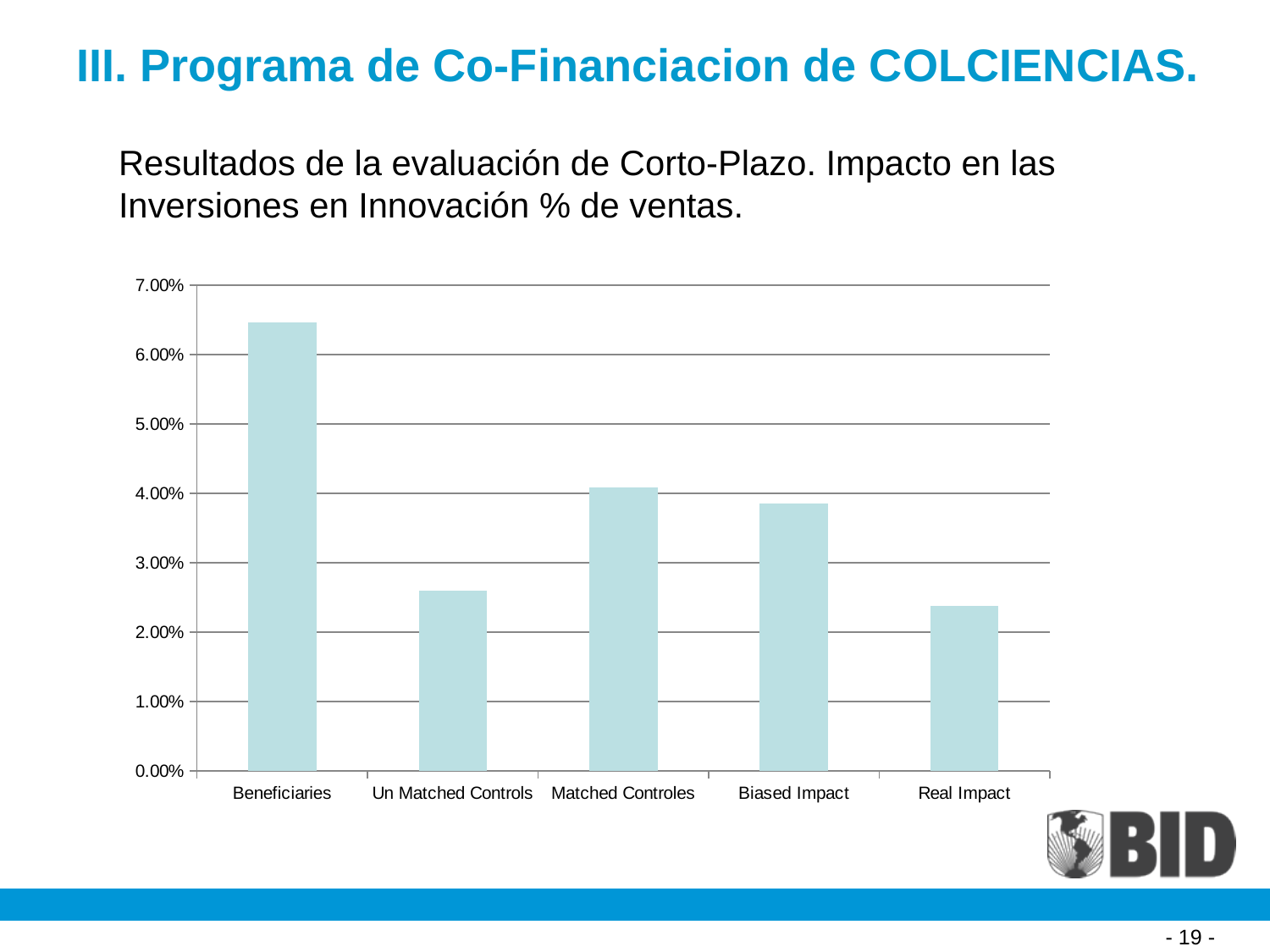
How many categories are shown on the x axis of the chart? 5 What kind of chart is shown on the slide? Bar chart Is the value for Biased Impact greater or less than 4.00%? less Which category has the highest value in the chart? Beneficiaries Is the value for Matched Controles greater or less than 5.00%? less Is the value for Real Impact greater or less than 3.00%? less Which is larger, the value for Un Matched Controls or the value for Biased Impact? Biased Impact What is the label of the first category on the x axis of the chart? Beneficiaries Which is larger, the value for Beneficiaries or the value for Matched Controles? Beneficiaries